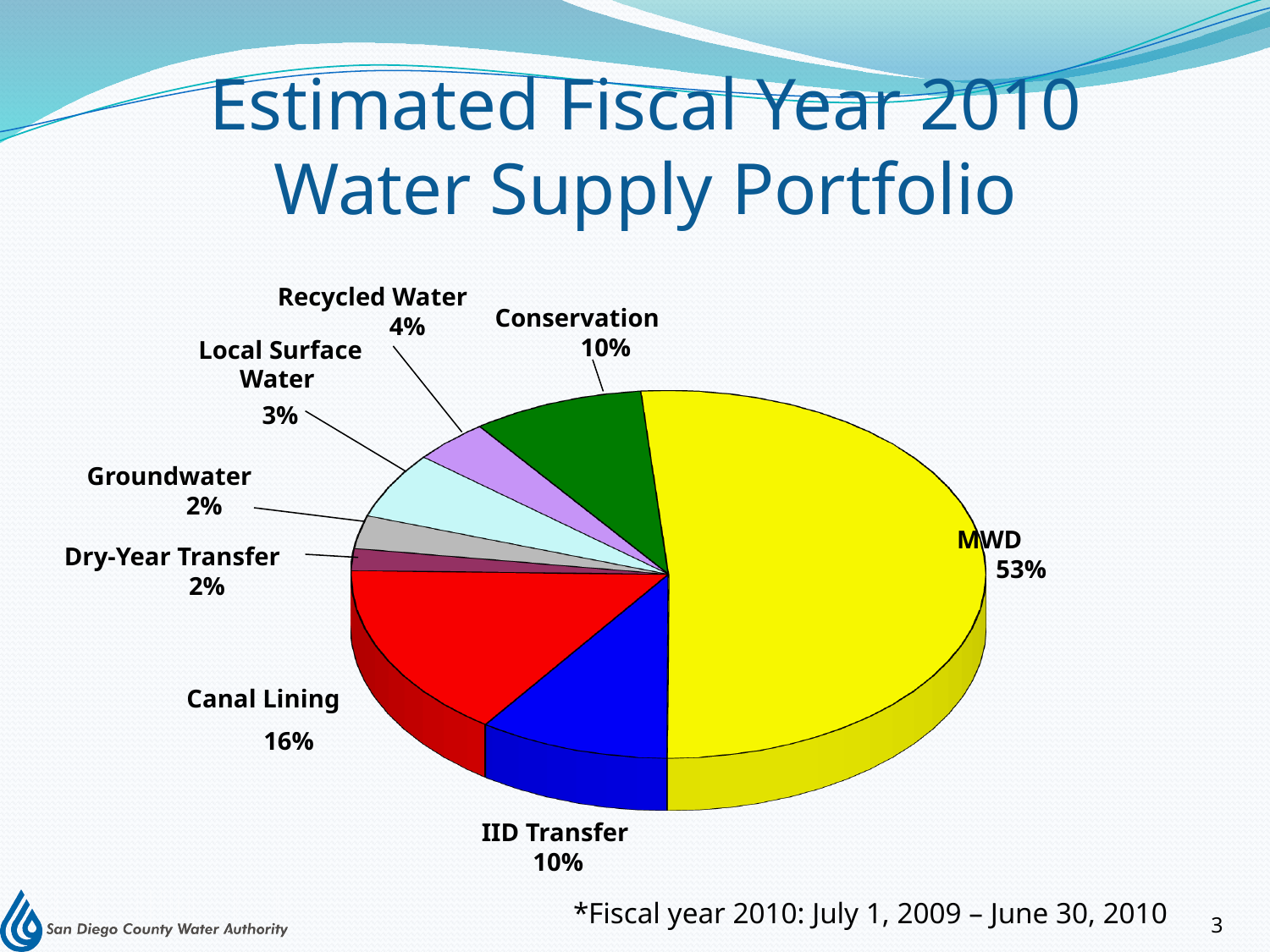
What percentage is shown for Canal Lining? 16% What type of chart is shown on the slide? Pie chart Which two sources each account for 2% of the portfolio? Groundwater and Dry-Year Transfer Which source has the largest share of the pie? MWD What colour is the MWD slice? Yellow What share of the water supply portfolio does MWD account for? 53% What is the difference in percentage points between MWD and Canal Lining? 37 What percentage is shown for Local Surface Water? 3% How many slices does the pie chart have? 8 Which is larger, the share for Canal Lining or the share for IID Transfer? Canal Lining What percentage is shown for Recycled Water? 4% What is the combined share of IID Transfer and Conservation? 20%